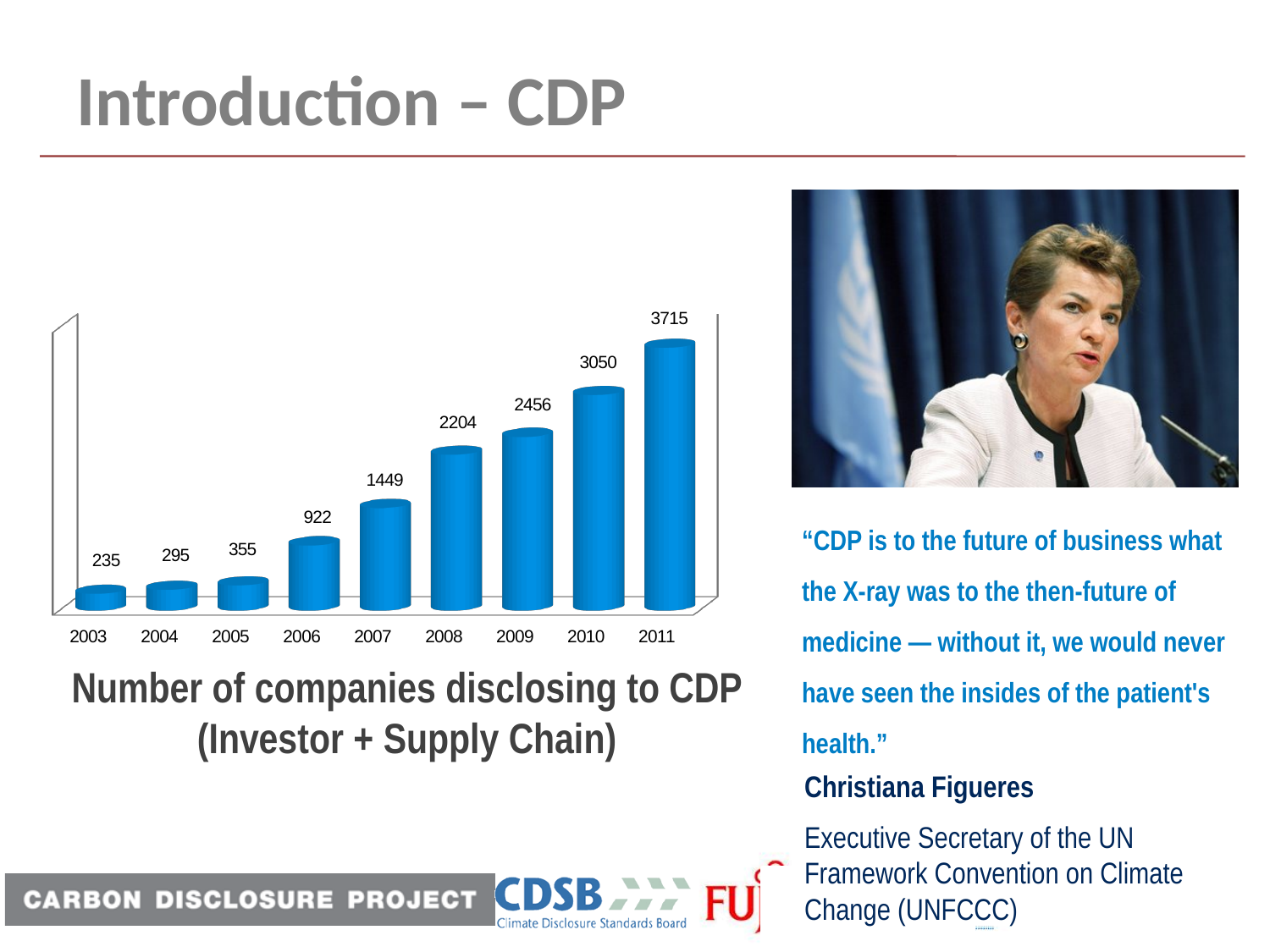
Which year has the lowest number of companies disclosing to CDP? 2003 What is the title shown below the chart? Number of companies disclosing to CDP (Investor + Supply Chain) Which year has the highest number of companies disclosing to CDP? 2011 What is the difference between the number of companies disclosing in 2006 and in 2005? 567 Which year has more companies disclosing to CDP, 2008 or 2009? 2009 What is the difference between the number of companies disclosing in 2011 and in 2010? 665 What is the number of companies disclosing to CDP in 2007? 1449 Do the values rise or fall from 2003 to 2011? Rise What is the number of companies disclosing to CDP in 2003? 235 What kind of chart is used to show the number of companies disclosing to CDP? Bar chart How many years are shown on the x axis of the chart? 9 What is the number of companies disclosing to CDP in 2011? 3715